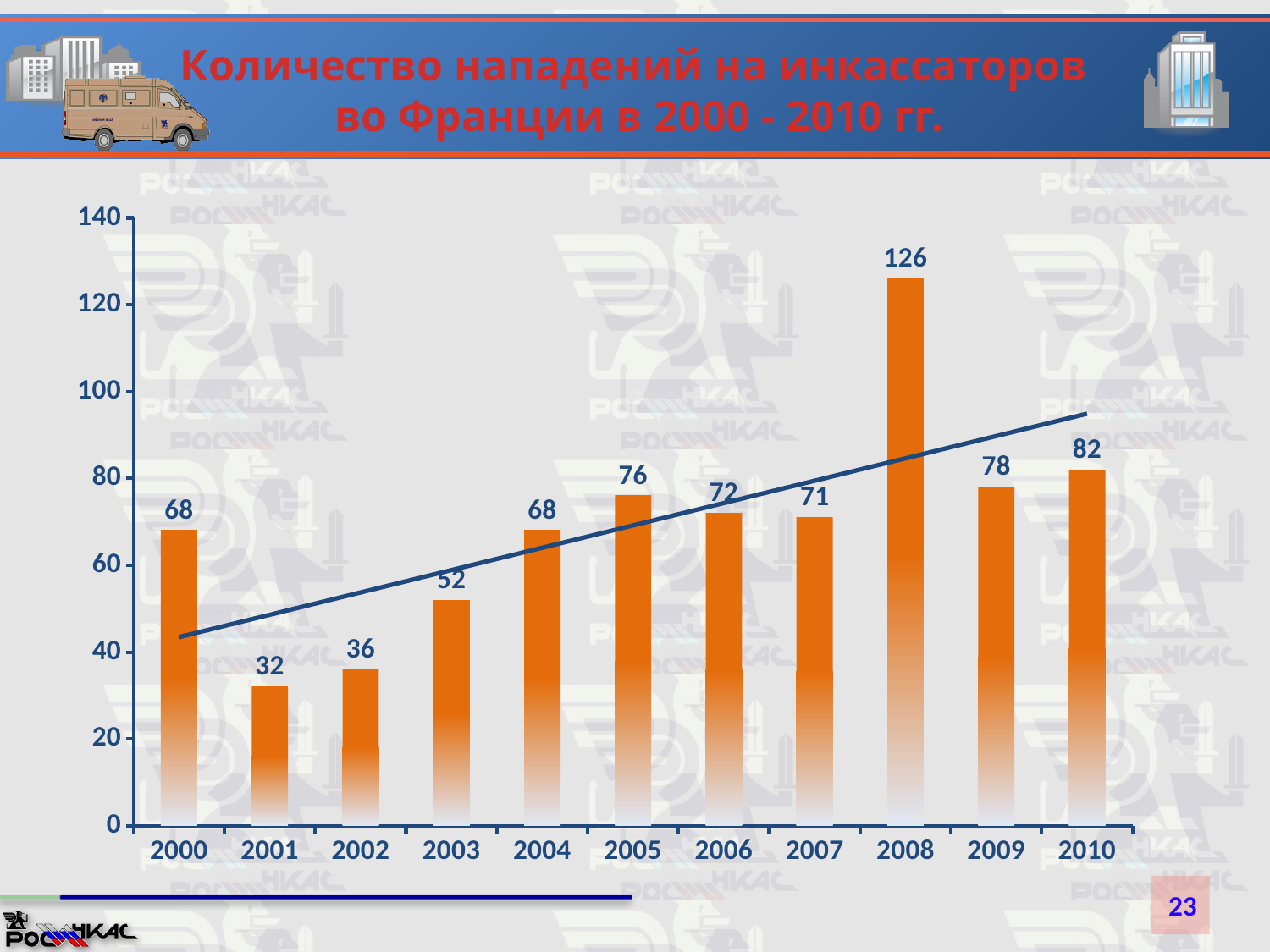
What is the value for 2001? 32 Which year has the lowest value? 2001 Which is larger, the value for 2000 or the value for 2003? 2000 What is the value for 2005? 76 What is the difference between the values for 2008 and 2009? 48 What is the difference between the values for 2003 and 2002? 16 Is the value for 2010 greater or less than 100? less Which year has the highest value? 2008 What kind of chart is shown on the slide? bar chart What is the value for 2008? 126 How many years are shown on the x axis? 11 Do the values generally rise or fall from 2001 to 2008? rise